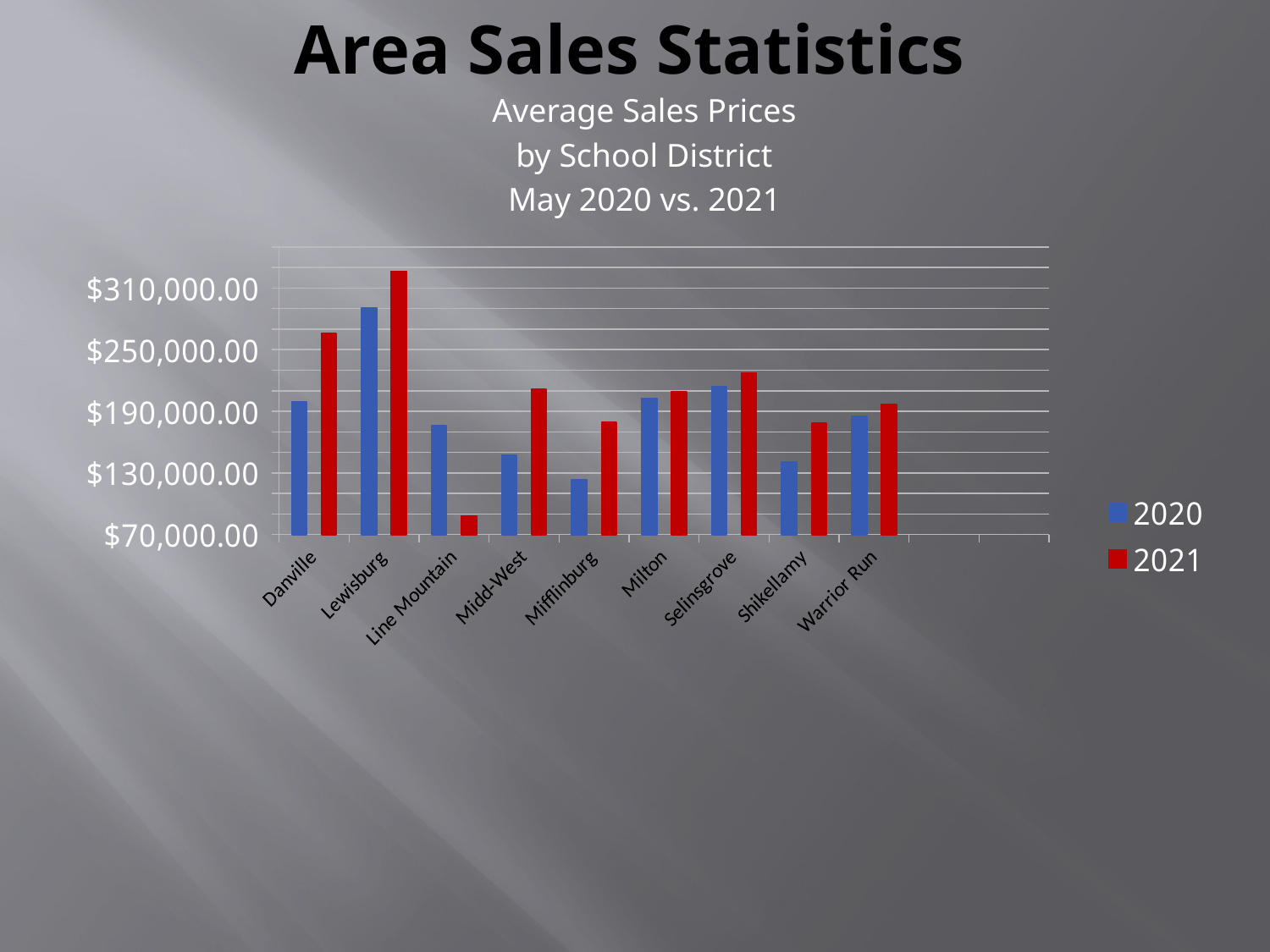
Which colour represents the 2021 series in the chart? red What kind of chart is shown on the slide? bar chart Which school district has the highest 2020 average sales price? Lewisburg Which school district has the lowest 2021 average sales price? Line Mountain How many series does the chart's legend list? 2 For Danville, which year has the higher average sales price, 2020 or 2021? 2021 Which school district has the lowest 2020 average sales price? Mifflinburg Which school district has the highest 2021 average sales price? Lewisburg Is the 2021 value for Line Mountain greater or less than $130,000.00? less Is the 2021 value for Lewisburg greater or less than $310,000.00? greater For Line Mountain, which year has the higher average sales price, 2020 or 2021? 2020 How many school districts are shown on the x axis of the chart? 9